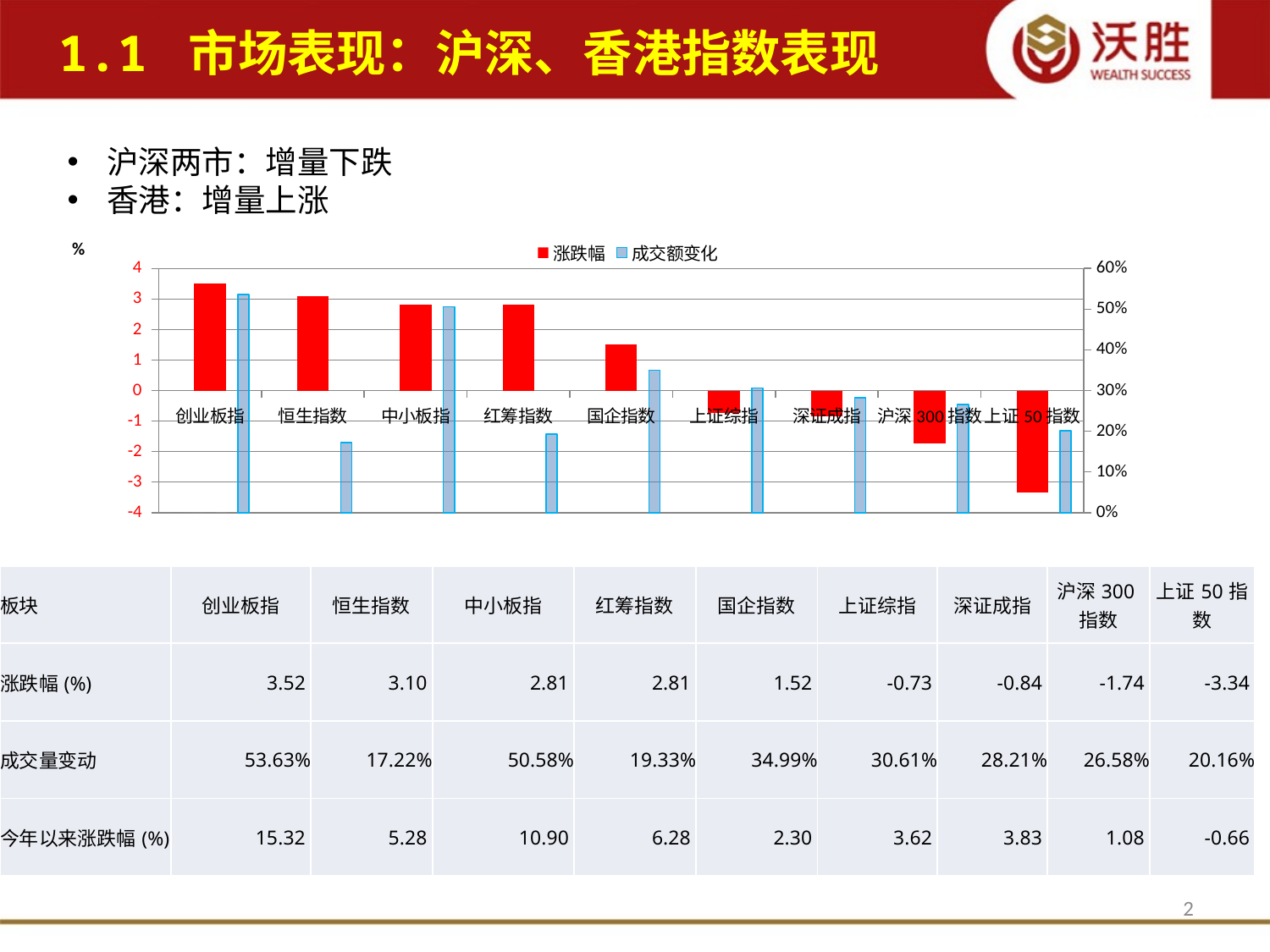
What is the 涨跌幅 (%) value for 国企指数? 1.52 Is the 成交额变化 value for 上证综指 greater or less than 20%? greater Do the 涨跌幅 (red bar) values rise or fall moving from left to right along the x axis? fall Which category has the lowest 涨跌幅 (red bar) in the chart? 上证50指数 Which has the larger 涨跌幅, 中小板指 or 国企指数? 中小板指 Which category has the highest 涨跌幅 (red bar) in the chart? 创业板指 Is the 涨跌幅 value for 恒生指数 greater or less than 2? greater What is the difference in 涨跌幅 (%) between 创业板指 and 恒生指数? 0.42 How many series does the chart legend list? 2 How many index categories are plotted along the x axis of the chart? 9 What kind of chart is shown on the slide? bar chart What is the 成交量变动 value for 中小板指? 50.58%